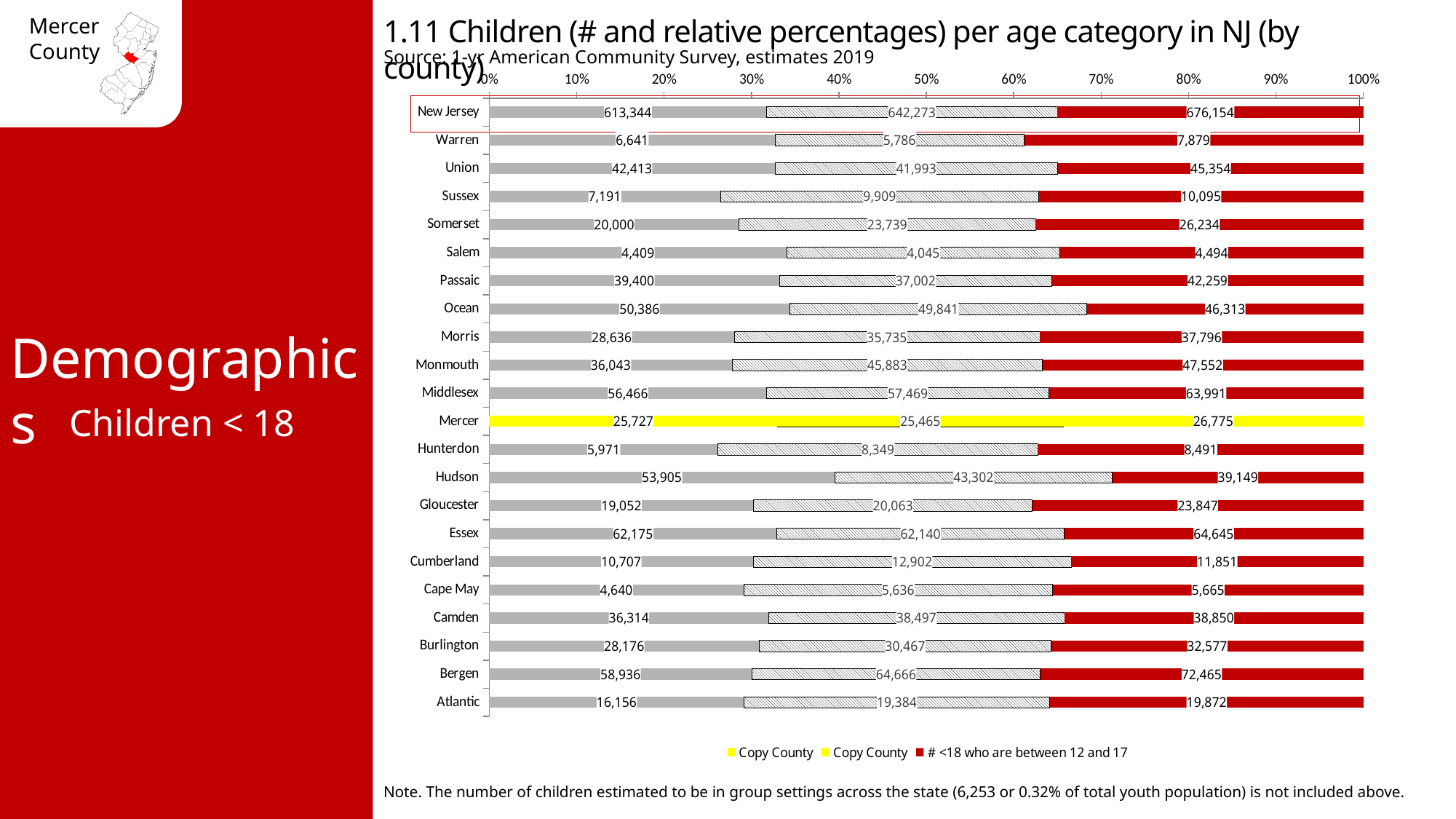
How many series does the legend list? 3 What is the value of the red segment (# <18 who are between 12 and 17) for Bergen? 72,465 What is the total of the three segments for Mercer? 77,967 Among the counties (excluding the New Jersey total), which has the highest value for # <18 who are between 12 and 17? Bergen Which is larger: the red segment for Ocean or the red segment for Union? Ocean Among the counties (excluding the New Jersey total), which has the lowest value for # <18 who are between 12 and 17? Salem What is the value of the red segment (# <18 who are between 12 and 17) for New Jersey? 676,154 What kind of chart is shown on the slide? Stacked bar chart What is the difference between Mercer's red segment (26,775) and its first grey segment (25,727)? 1,048 What is the value of the first (grey) segment for Mercer? 25,727 What is the value of the middle (hatched) segment for Hudson? 43,302 How many rows (categories) are plotted on the chart? 22